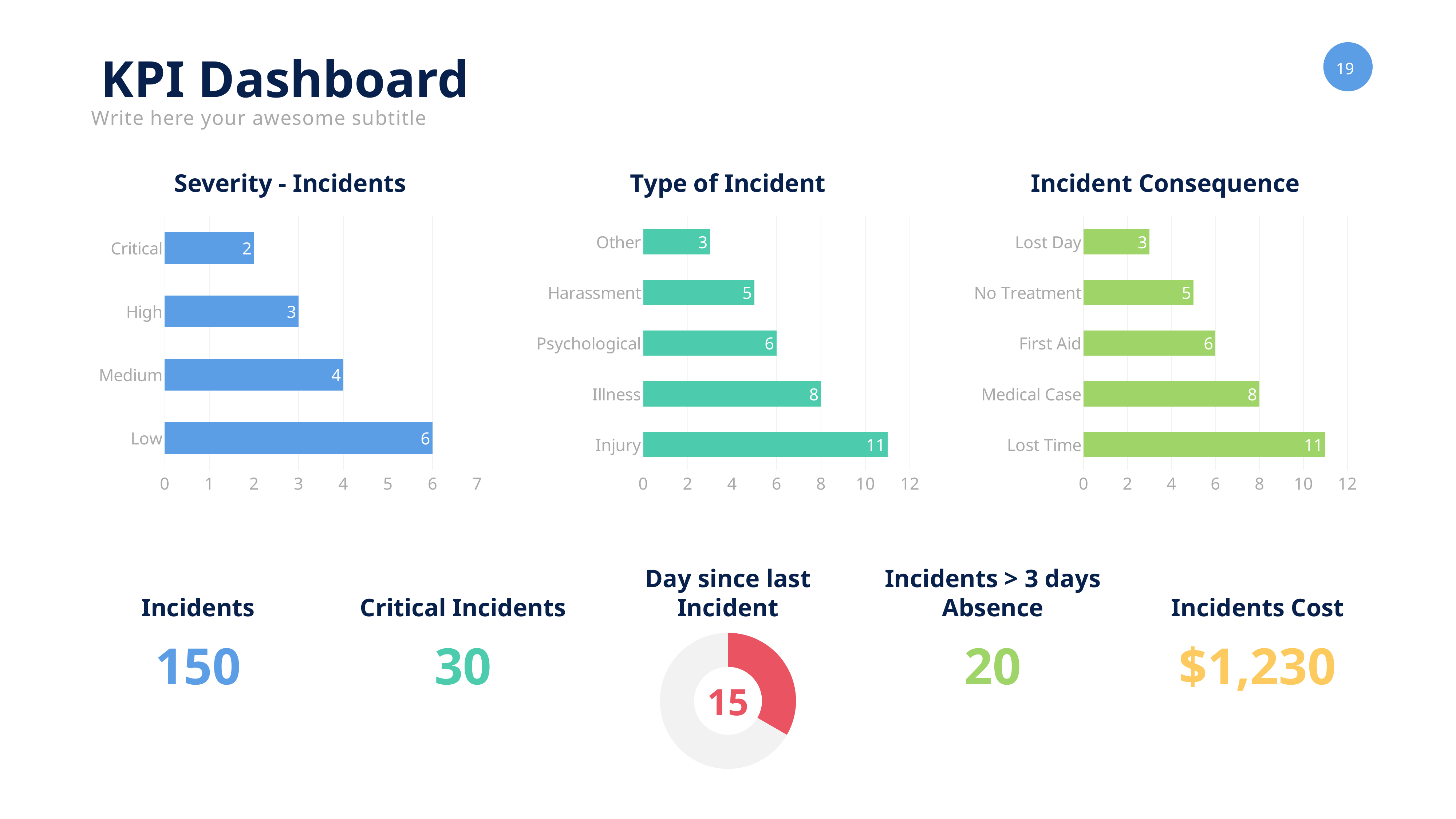
In the 'Severity - Incidents' chart, how many categories are shown? 4 What kind of chart is the 'Severity - Incidents' chart? Bar chart In the 'Incident Consequence' chart, what is the value for Medical Case? 8 In the 'Severity - Incidents' chart, which category has the highest value? Low In the 'Type of Incident' chart, which is larger, Illness or Psychological? Illness In the 'Severity - Incidents' chart, what is the difference between Low and Critical? 4 In the 'Severity - Incidents' chart, what is the value for Medium? 4 In the 'Type of Incident' chart, how many categories are shown? 5 In the 'Type of Incident' chart, what is the value for Harassment? 5 In the 'Incident Consequence' chart, what is the difference between Lost Time and First Aid? 5 In the 'Incident Consequence' chart, which category has the highest value? Lost Time In the 'Type of Incident' chart, which category has the lowest value? Other